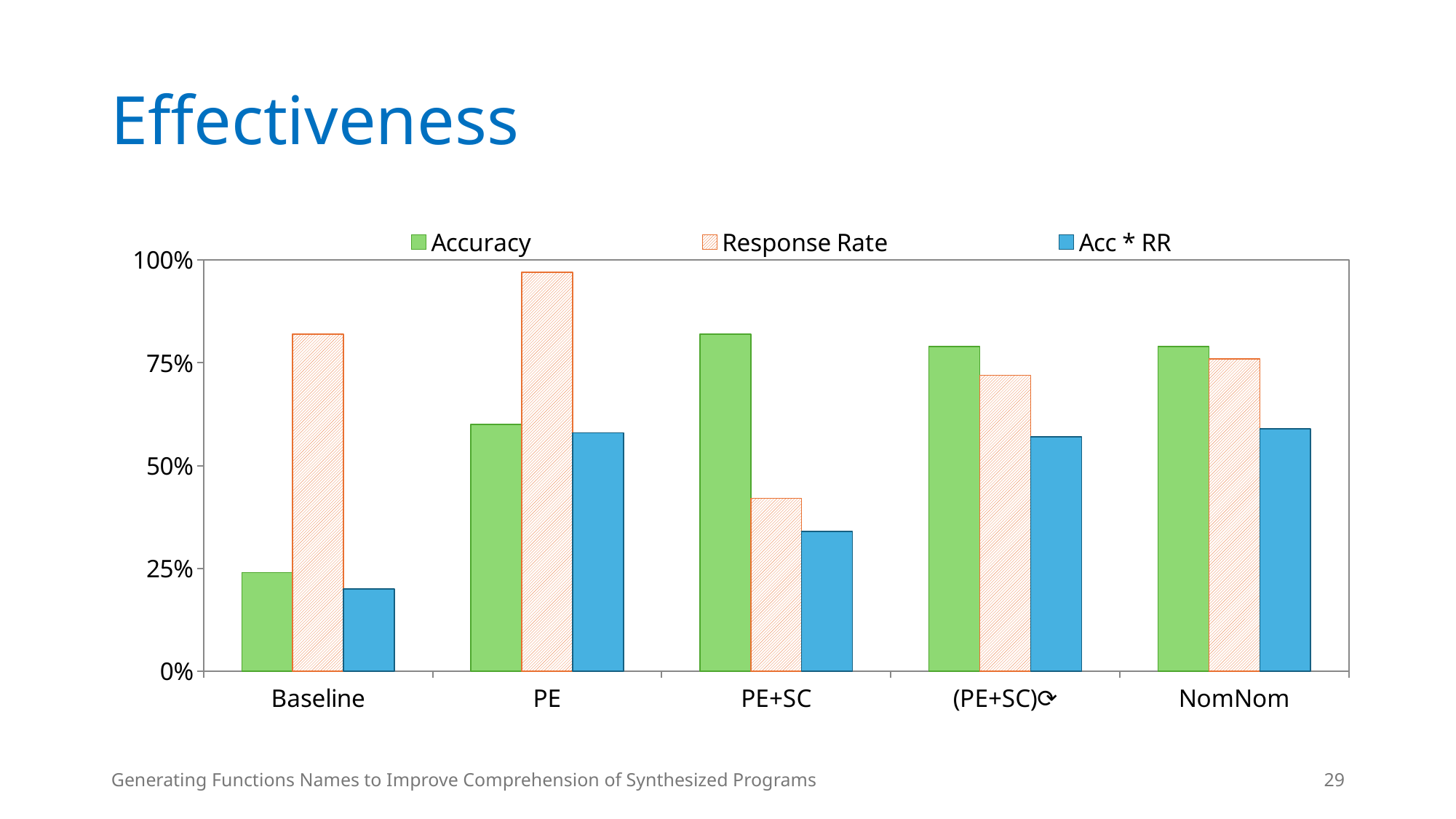
Is the Accuracy for PE greater or less than 50%? greater What kind of chart is shown on the slide? bar chart How many categories are shown on the x axis? 5 How many series does the legend list? 3 Which category has the highest Response Rate? PE Which category has the lowest Response Rate? PE+SC Is the Response Rate for PE+SC greater or less than 50%? less Is the Response Rate for Baseline greater or less than 75%? greater For Baseline, which is larger: Accuracy or Response Rate? Response Rate What is the title of the slide containing the chart? Effectiveness Which category has the lowest Acc * RR value? Baseline Which category has the lowest Accuracy? Baseline